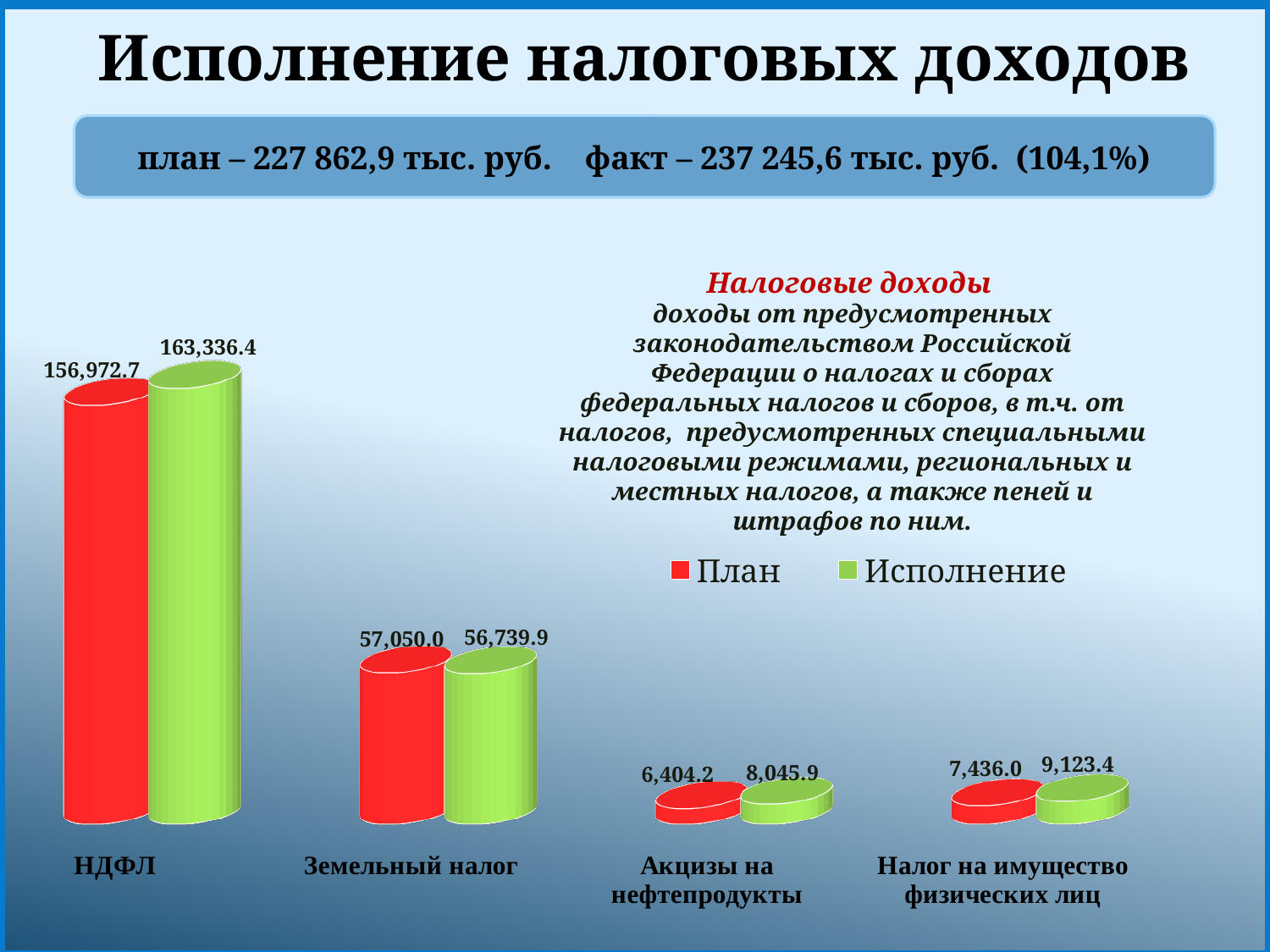
What is the Исполнение value for Акцизы на нефтепродукты? 8,045.9 What kind of chart is shown on the slide? Bar chart Which category has the highest Исполнение value? НДФЛ Which is larger for Налог на имущество физических лиц: the План value or the Исполнение value? Исполнение What is the План value for Налог на имущество физических лиц? 7,436.0 What is the План value for НДФЛ? 156,972.7 What is the difference between the План and Исполнение values for Земельный налог? 310.1 How many series does the legend list? 2 What is the Исполнение value for Земельный налог? 56,739.9 Which category has the lowest План value? Акцизы на нефтепродукты How many categories are shown on the chart? 4 What is the difference between the Исполнение and План values for НДФЛ? 6,363.7